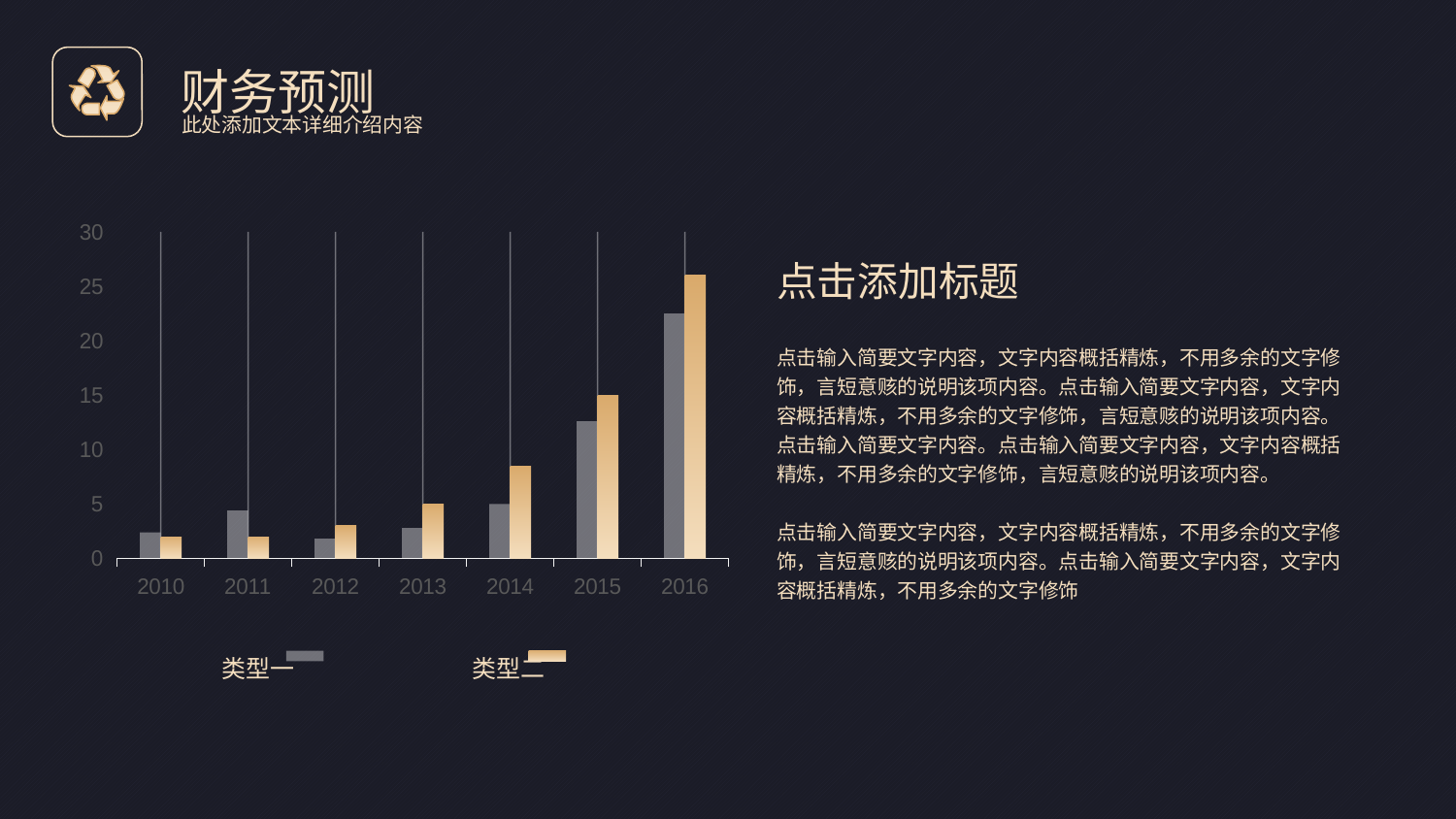
Is the value for 类型一 in 2014 greater or less than 10? less Which year has the highest value for 类型二? 2016 What kind of chart is shown on the slide? bar chart Is the value for 类型一 in 2016 greater or less than 25? less In 2015, which series has the larger value, 类型一 or 类型二? 类型二 Is the value for 类型二 in 2016 greater or less than 25? greater How many years are shown on the x axis of the chart? 7 What are the two legend entries of the chart? 类型一 and 类型二 Which year has the highest value for 类型一? 2016 Do the values for 类型二 generally rise or fall from 2012 to 2016? rise How many series does the chart legend list? 2